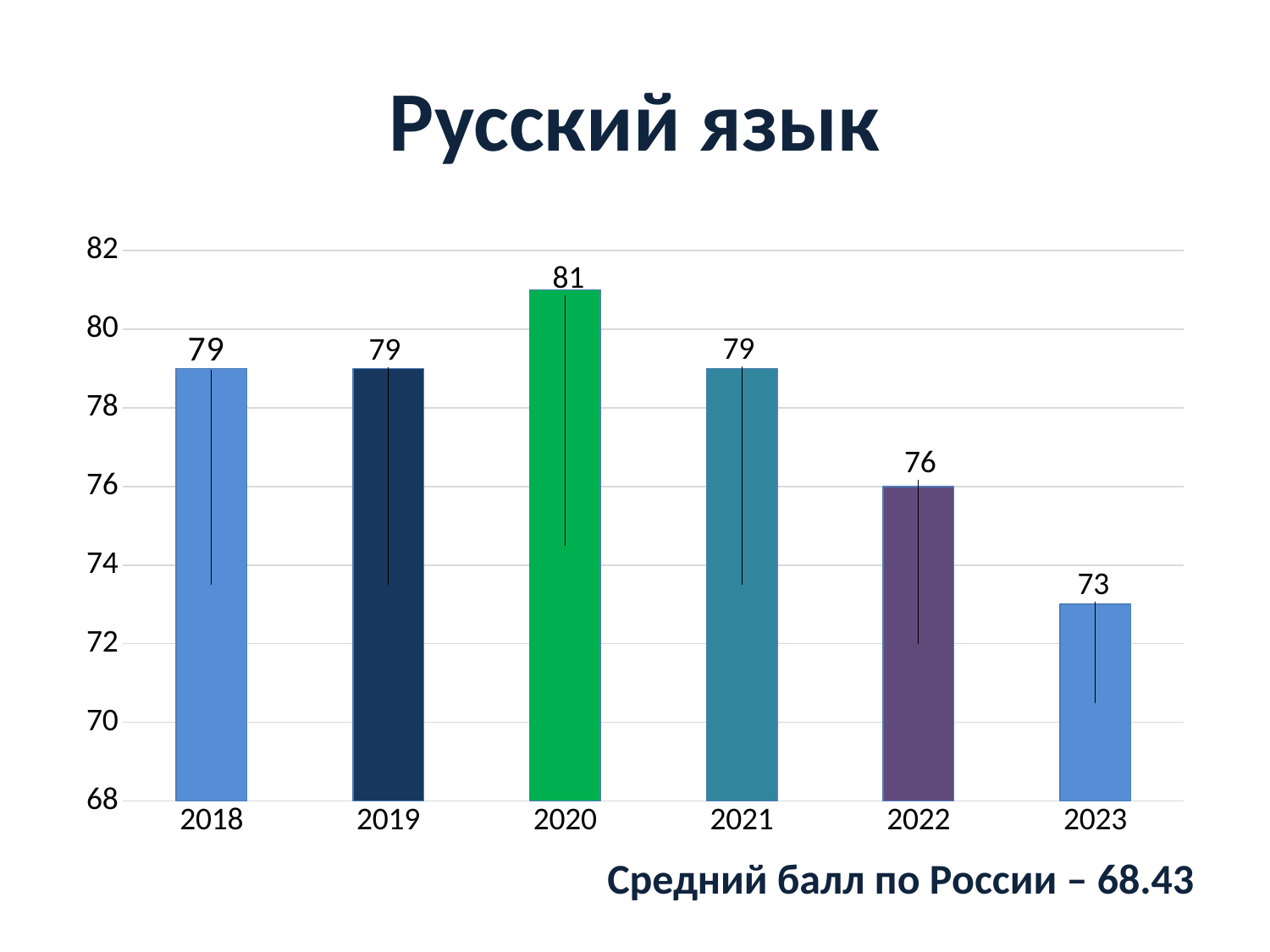
Which year has the lowest value? 2023 What is the value for 2020? 81 What is the value for 2022? 76 Which is larger, the value for 2019 or the value for 2022? 2019 What kind of chart is shown on the slide? bar chart What is the difference between the values for 2020 and 2023? 8 What is the value for 2023? 73 Which year has the highest value? 2020 What is the difference between the values for 2021 and 2022? 3 What is the title of the chart? Русский язык How many years are shown on the chart? 6 Is the value for 2022 greater or less than 78? less